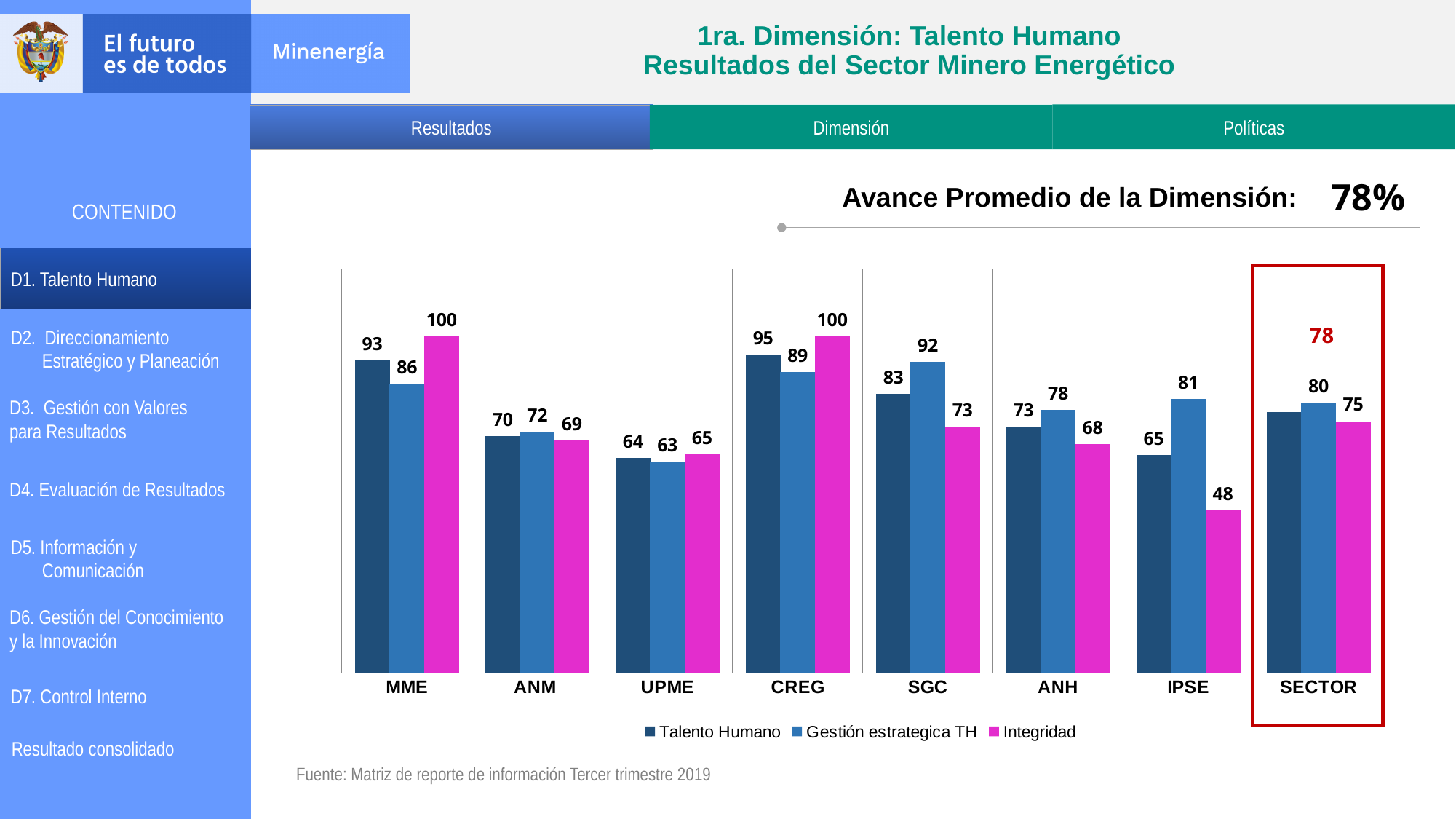
What is the Avance Promedio de la Dimensión shown above the chart? 78% What is the difference between the Gestión estrategica TH value for SGC and the Integridad value for SGC? 19 What is the Talento Humano value for CREG? 95 How many entities are shown on the x axis of the chart? 8 What kind of chart is shown on the slide? Bar chart How many series does the legend list? 3 Which entity has the lowest Integridad value? IPSE Which entity has the highest Talento Humano value? CREG Which is larger for ANH: the Talento Humano value or the Gestión estrategica TH value? Gestión estrategica TH What is the Talento Humano value for SECTOR? 78 What is the Gestión estrategica TH value for IPSE? 81 What is the Integridad value for MME? 100